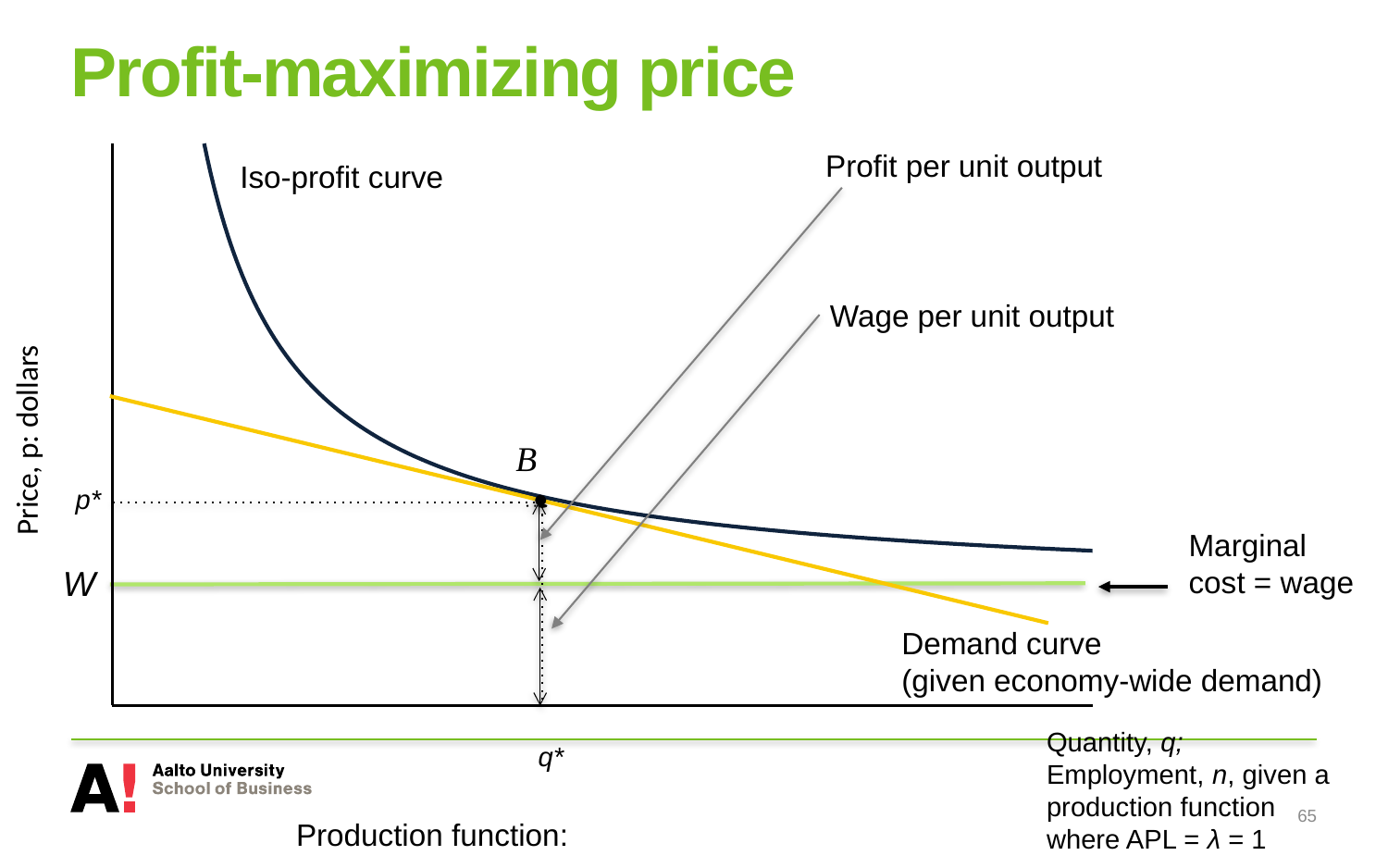
What is the title of the slide containing the chart? Profit-maximizing price Does the iso-profit curve rise or fall as quantity increases along the x axis? fall What does the vertical gap between p* and W at q* represent, according to the label? Profit per unit output What quantity on the x axis corresponds to point B? q* What is the label of the vertical axis of the chart? Price, p: dollars Which is higher on the price axis, p* or W? p* Does the demand curve rise or fall as quantity increases along the x axis? fall What is the label of the point where the demand curve touches the iso-profit curve? B What price on the y axis corresponds to point B? p* How many curves are drawn in the chart (excluding the dotted guide lines)? 3 Which curve is horizontal in the chart? Marginal cost = wage (W) What does the vertical gap between W and the x axis at q* represent, according to the label? Wage per unit output